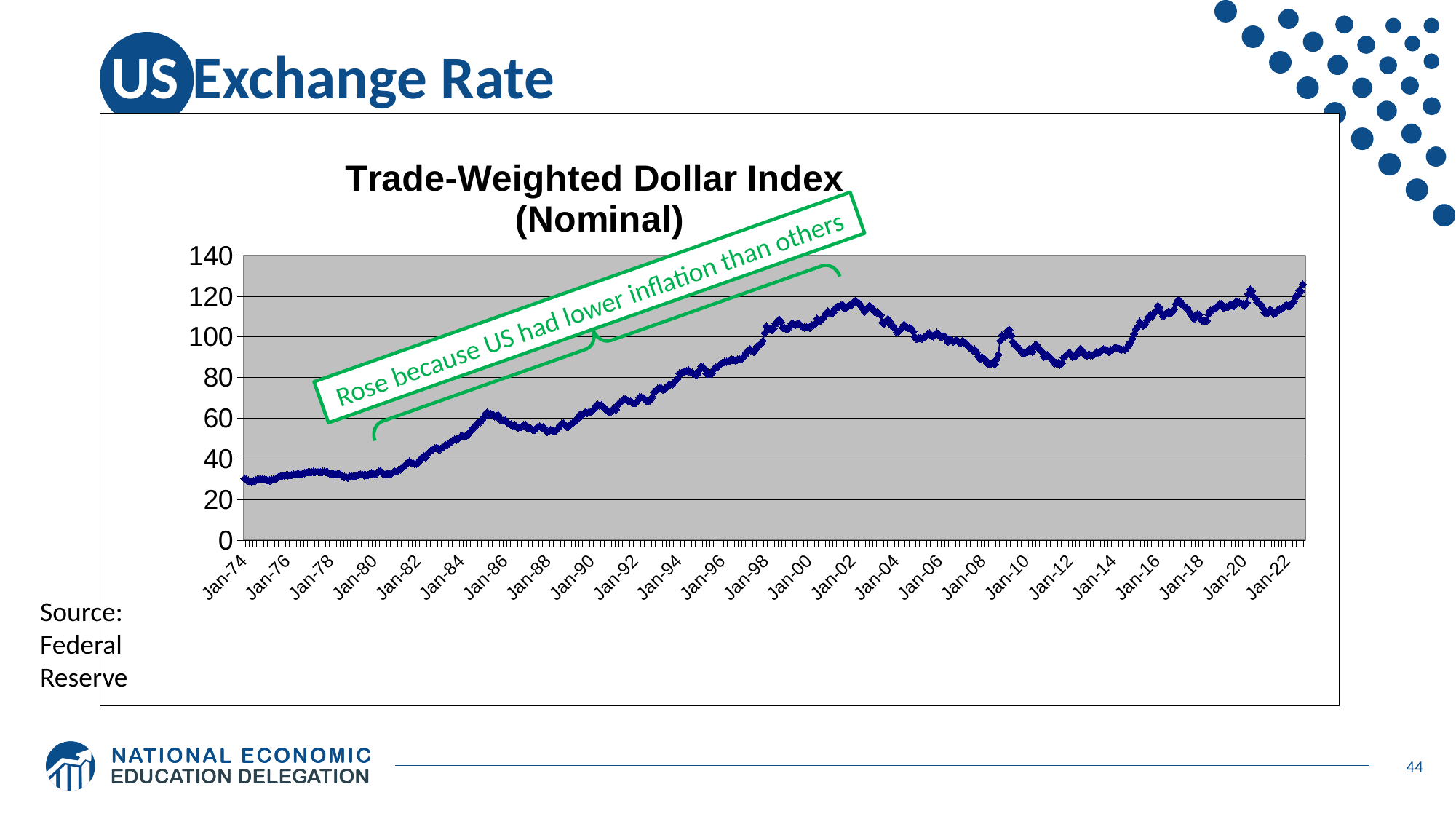
What does the green annotation on the chart say? Rose because US had lower inflation than others Is the value of the index at Jan-12 greater or less than 100? less Is the value of the index at Jan-80 greater or less than 40? less Is the value of the index at Jan-22 greater or less than 100? greater What is the highest value shown on the y axis? 140 Which is larger, the index value at Jan-86 or at Jan-12? Jan-12 What kind of chart is shown on the slide? line chart Overall, does the Trade-Weighted Dollar Index rise or fall from Jan-74 to Jan-22? rise Which is larger, the index value at Jan-02 or at Jan-74? Jan-02 What is the title of the chart? Trade-Weighted Dollar Index (Nominal)